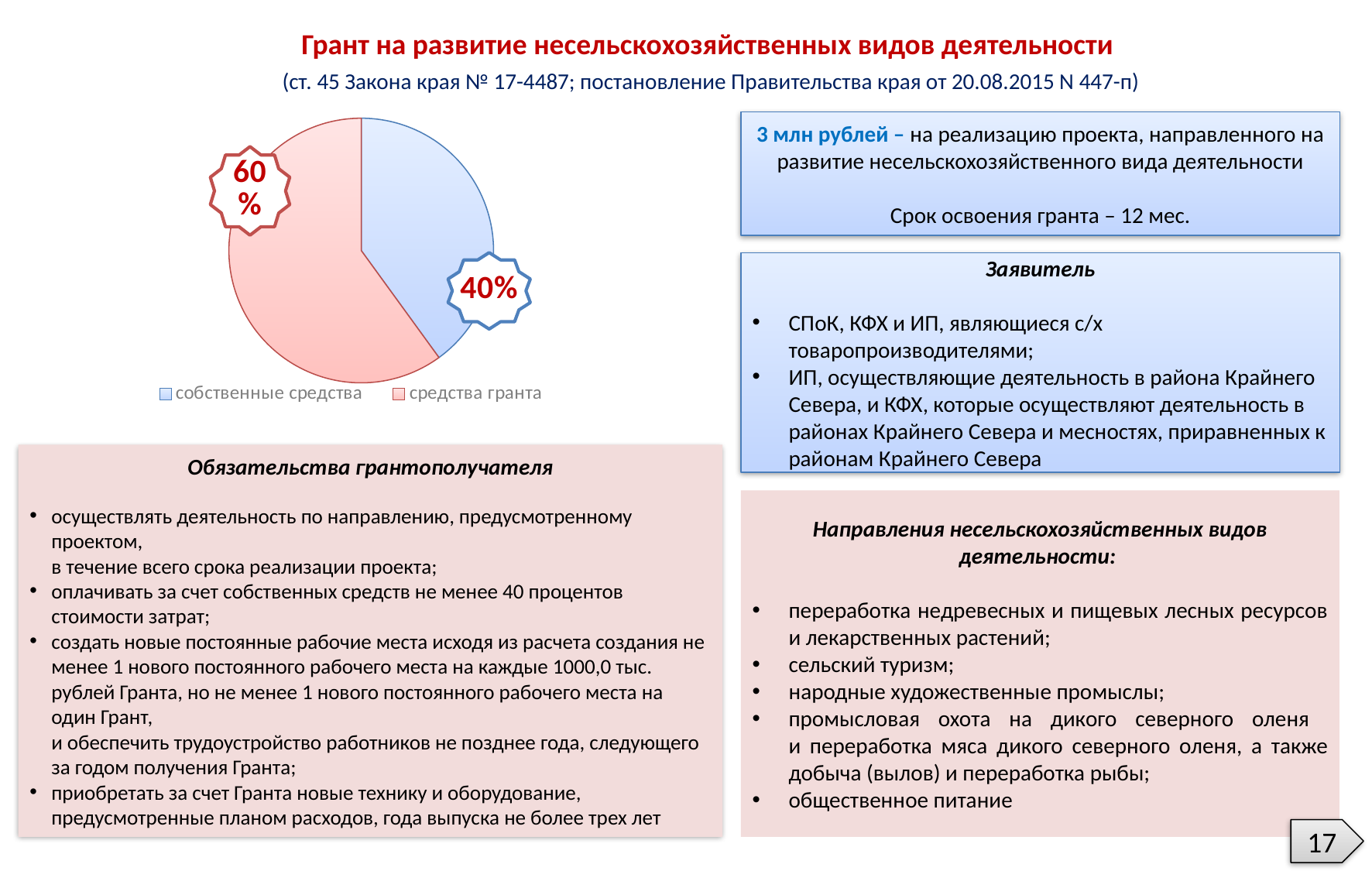
Which is larger in the pie chart: "собственные средства" or "средства гранта"? средства гранта What colour is the "собственные средства" slice in the pie chart? blue Is the share for "средства гранта" greater or less than 50%? greater What colour is the "средства гранта" slice in the pie chart? pink What share of the pie chart is labelled for "средства гранта"? 60% Which slice of the pie chart is the largest? средства гранта What share of the pie chart is labelled for "собственные средства"? 40% What kind of chart is shown on the slide? pie chart How many slices does the pie chart have? 2 Which slice of the pie chart is the smallest? собственные средства What is the difference in percentage points between the "средства гранта" slice and the "собственные средства" slice? 20% How many entries does the legend of the pie chart list? 2